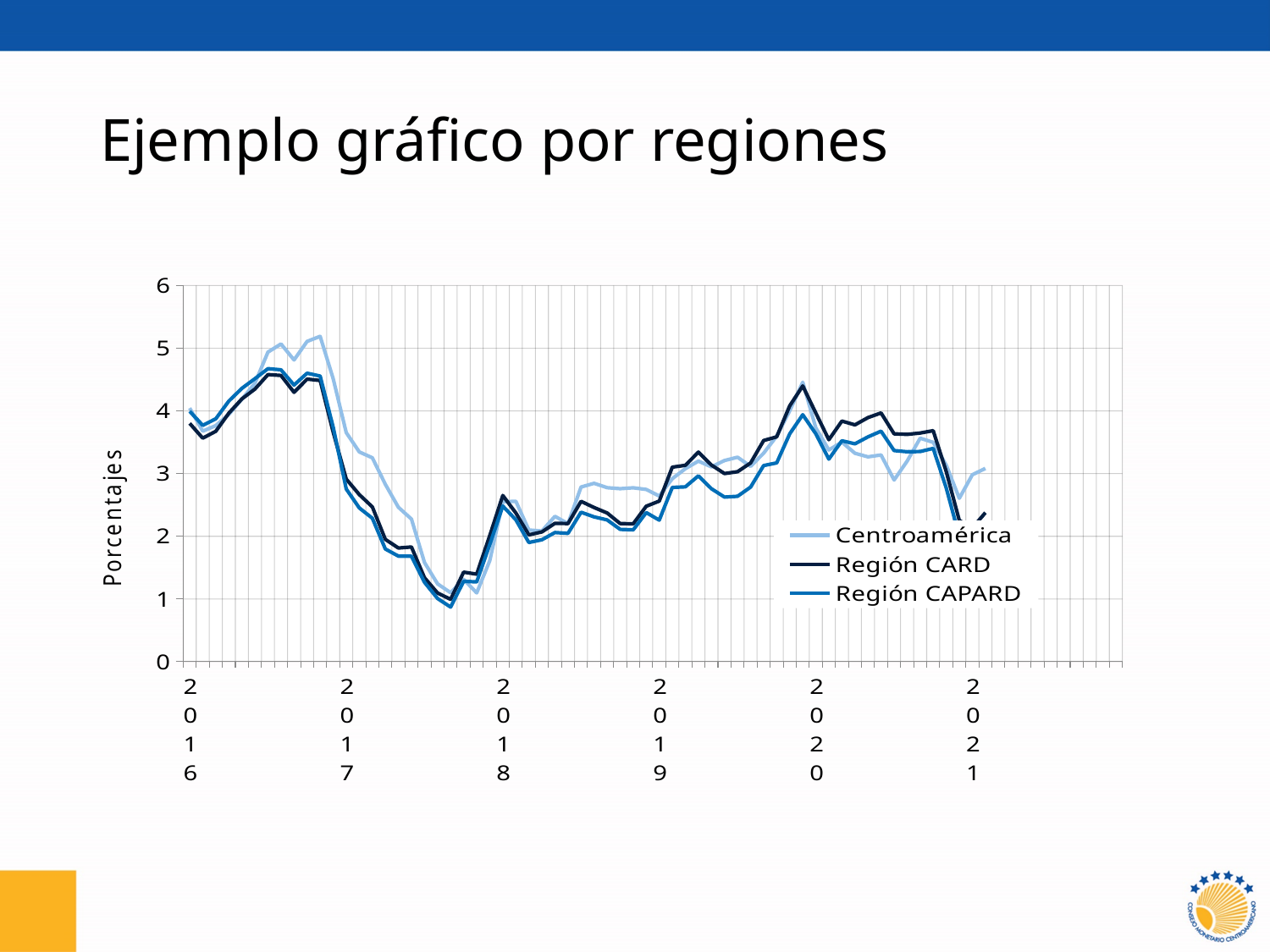
What are the three series named in the legend? Centroamérica, Región CARD, Región CAPARD Is the value of Región CARD at the start of 2016 greater or less than 4? less Is the highest value reached by the Región CARD series greater or less than 4? greater Which series reaches the highest peak on the chart? Centroamérica In early 2017, which series is higher: Centroamérica or Región CARD? Centroamérica Is the highest value reached by the Centroamérica series greater or less than 5? greater Do the values of the series rise or fall between the start of 2017 and the start of 2018? fall How many years are labelled on the horizontal axis? 6 What is the title of the vertical axis? Porcentajes What kind of chart is shown on the slide? line chart How many series does the legend list? 3